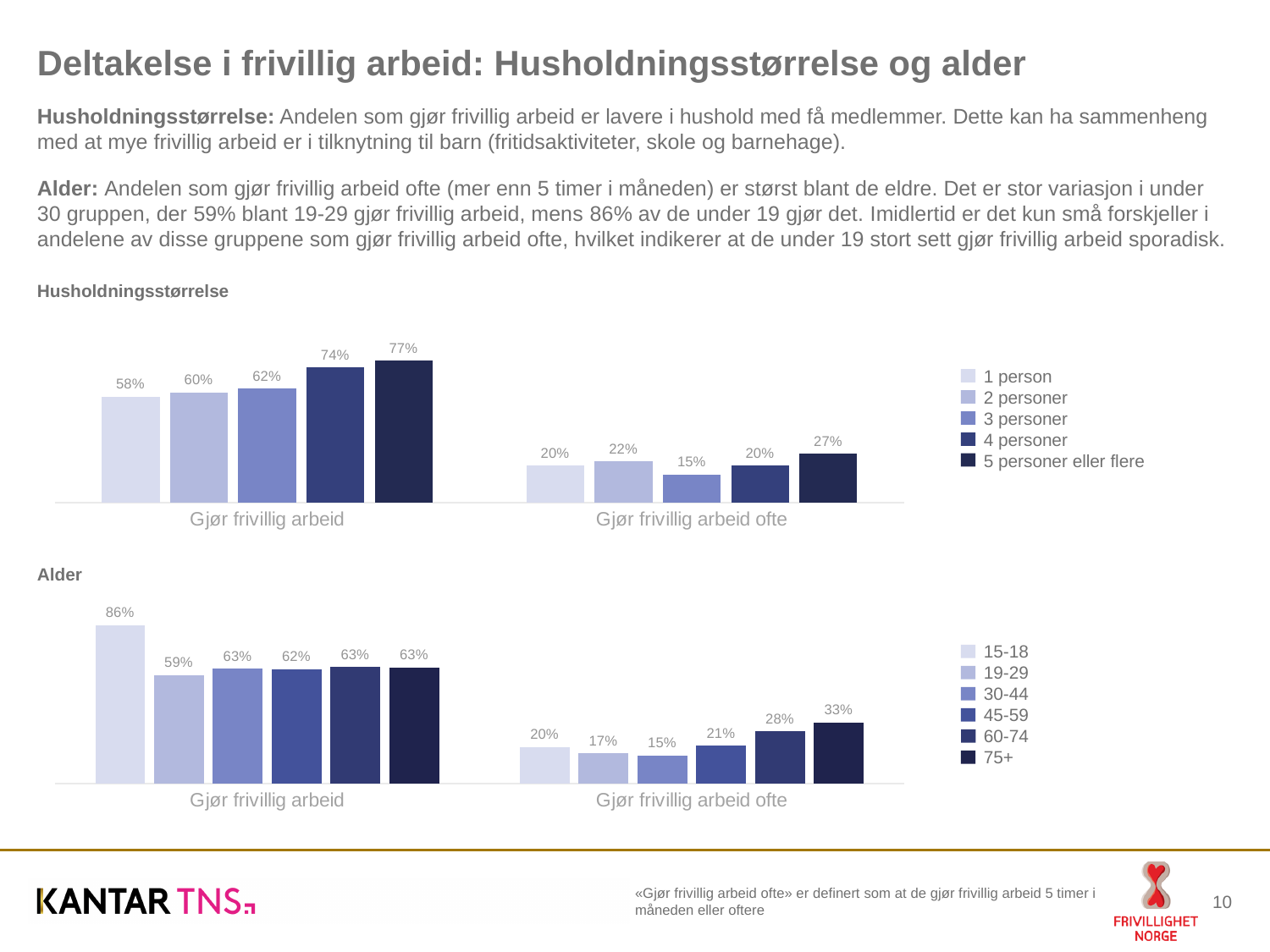
In the Alder chart, which age group has the lowest value under 'Gjør frivillig arbeid'? 19-29 In the Alder chart, what is the value for the 15-18 group under 'Gjør frivillig arbeid'? 86% In the Husholdningsstørrelse chart, do the values rise or fall from '1 person' to '5 personer eller flere' under 'Gjør frivillig arbeid'? rise In the Husholdningsstørrelse chart, what is the difference between '5 personer eller flere' and '1 person' under 'Gjør frivillig arbeid'? 19 percentage points In the Husholdningsstørrelse chart, which household size has the lowest value under 'Gjør frivillig arbeid'? 1 person In the Husholdningsstørrelse chart, how many series does the legend list? 5 In the Husholdningsstørrelse chart, what is the value for '3 personer' under 'Gjør frivillig arbeid ofte'? 15% What type of chart is the Alder chart? bar chart In the Alder chart, which is larger under 'Gjør frivillig arbeid ofte': the 60-74 group or the 30-44 group? 60-74 In the Husholdningsstørrelse chart, what is the value for '5 personer eller flere' under 'Gjør frivillig arbeid'? 77% In the Alder chart, which age group has the highest value under 'Gjør frivillig arbeid ofte'? 75+ In the Alder chart, what is the value for the 75+ group under 'Gjør frivillig arbeid ofte'? 33%